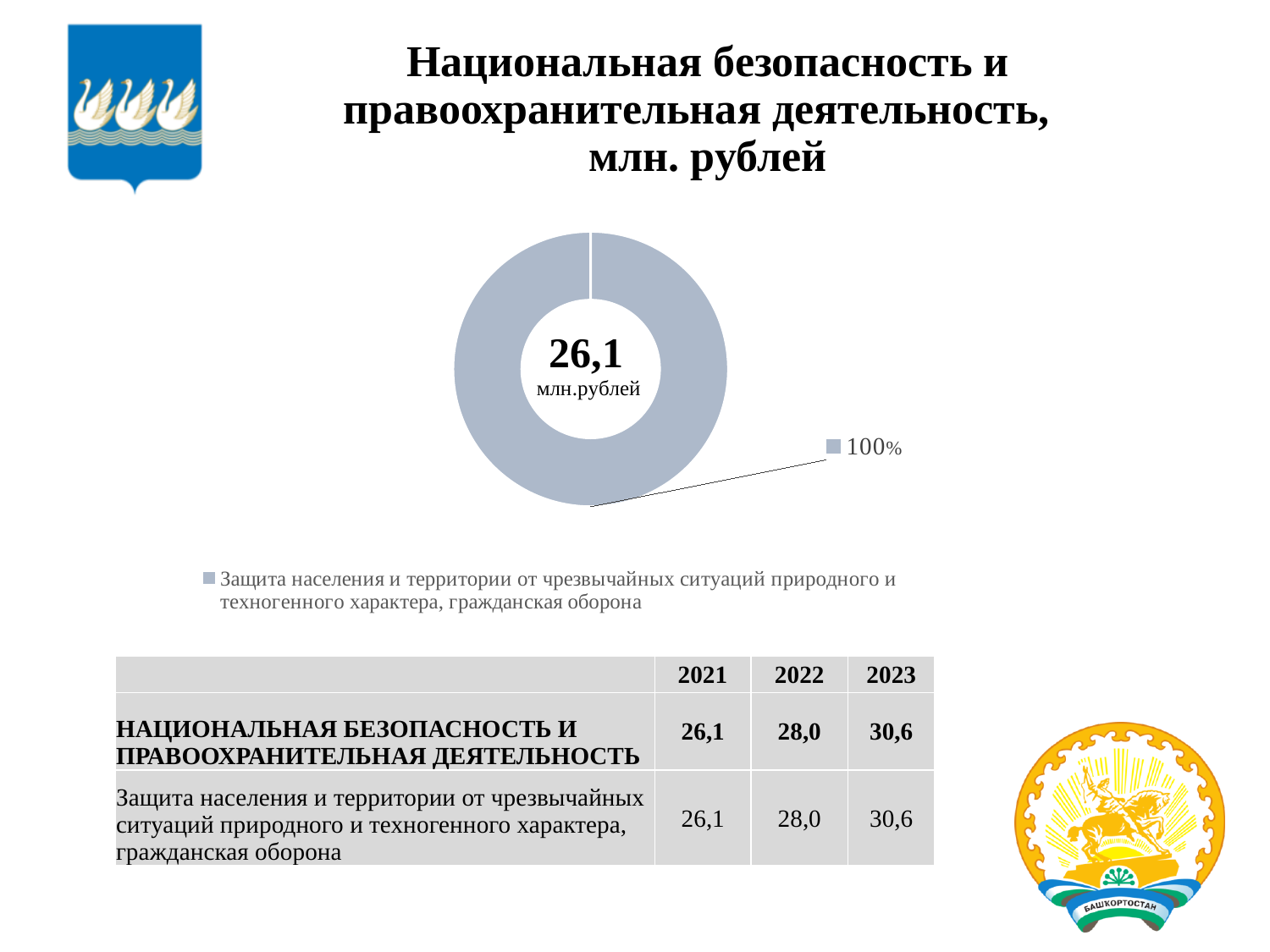
What is the title of the chart on the slide? Национальная безопасность и правоохранительная деятельность, млн. рублей How many slices does the pie chart have? 1 What total value is printed in the centre of the doughnut chart? 26,1 млн.рублей How many entries does the chart legend list? 1 What kind of chart is shown on the slide? Pie (doughnut) chart What share of the pie does the slice for «Защита населения и территории от чрезвычайных ситуаций природного и техногенного характера, гражданская оборона» represent? 100% What percentage label is shown next to the single slice of the chart? 100% What category does the legend entry of the chart name? Защита населения и территории от чрезвычайных ситуаций природного и техногенного характера, гражданская оборона